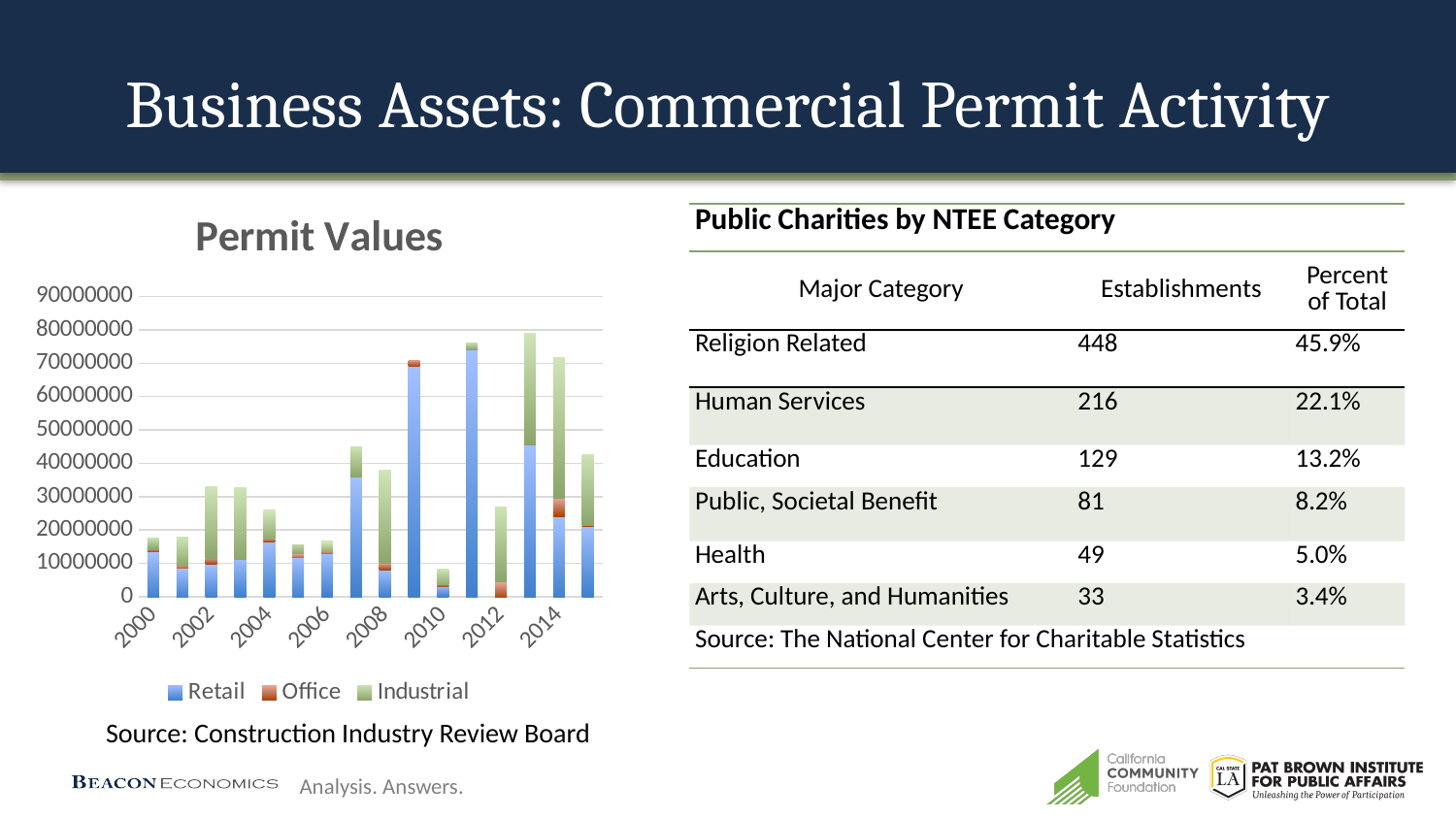
Which year has the larger total permit value, 2009 or 2008? 2009 What source is cited below the Permit Values chart? Construction Industry Review Board Which year has the larger total permit value, 2002 or 2004? 2002 Which year has the lowest total permit value in the Permit Values chart? 2010 How many series does the legend of the Permit Values chart list? 3 What are the three series shown in the legend of the Permit Values chart? Retail, Office, Industrial What type of chart is the Permit Values chart? bar chart How many bars (years) are plotted in the Permit Values chart? 16 Is the total permit value for 2007 greater or less than 40000000? greater Is the total permit value for 2010 greater or less than 10000000? less Is the total permit value for 2005 greater or less than 20000000? less